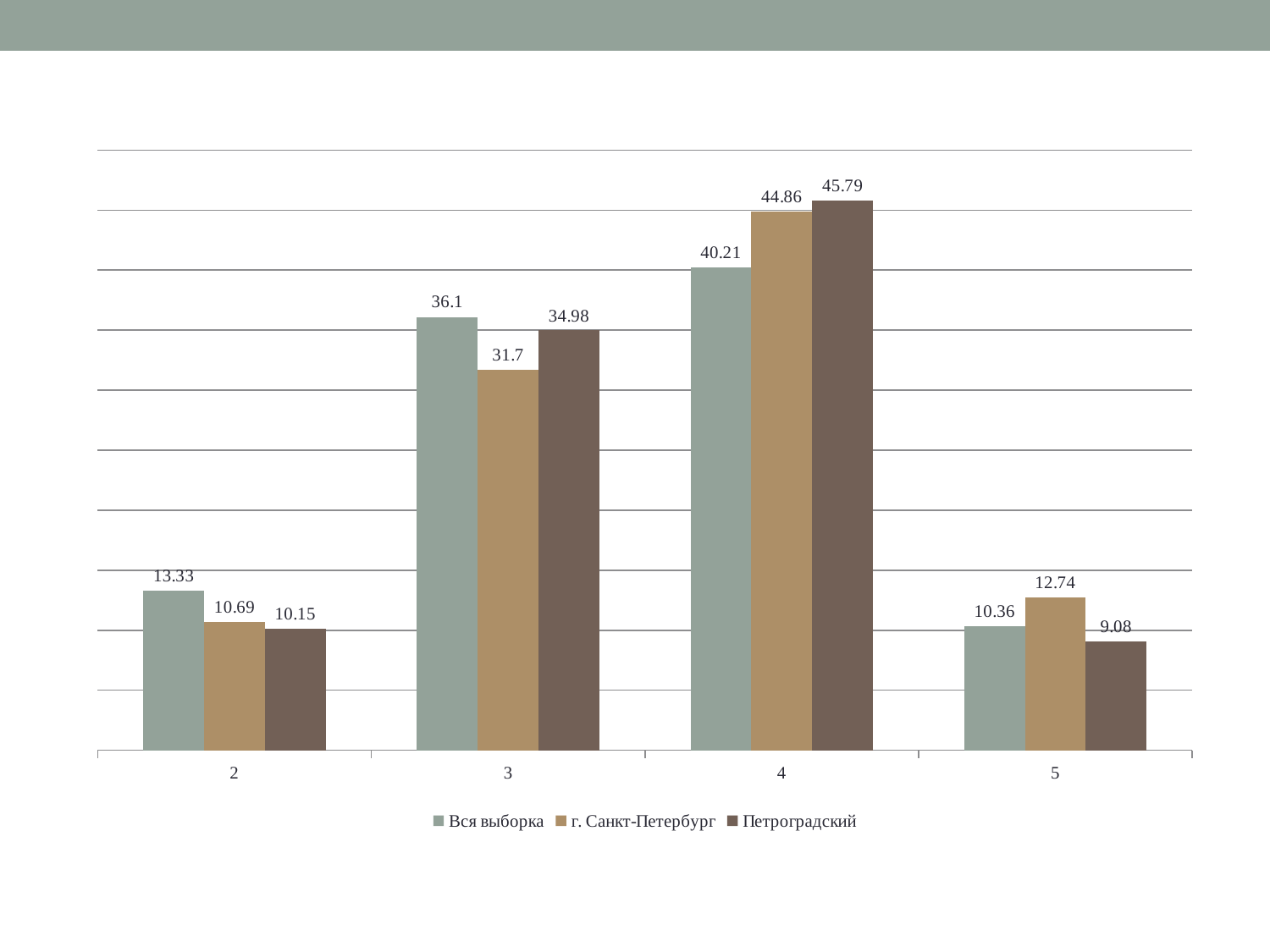
What is the difference between 'Петроградский' and 'Вся выборка' in category 4? 5.58 What type of chart is shown on the slide? Bar chart In which category does 'Петроградский' have its highest value? 4 In which category does 'Вся выборка' have its lowest value? 5 What is the value for 'Вся выборка' in category 3? 36.1 How many categories are shown on the x axis? 4 What is the value for 'г. Санкт-Петербург' in category 4? 44.86 What is the value for 'Петроградский' in category 5? 9.08 In category 3, which is larger: 'г. Санкт-Петербург' or 'Петроградский'? Петроградский What is the value for 'Петроградский' in category 2? 10.15 Which series is shown in the darkest brown colour in the legend? Петроградский How many series does the legend list? 3